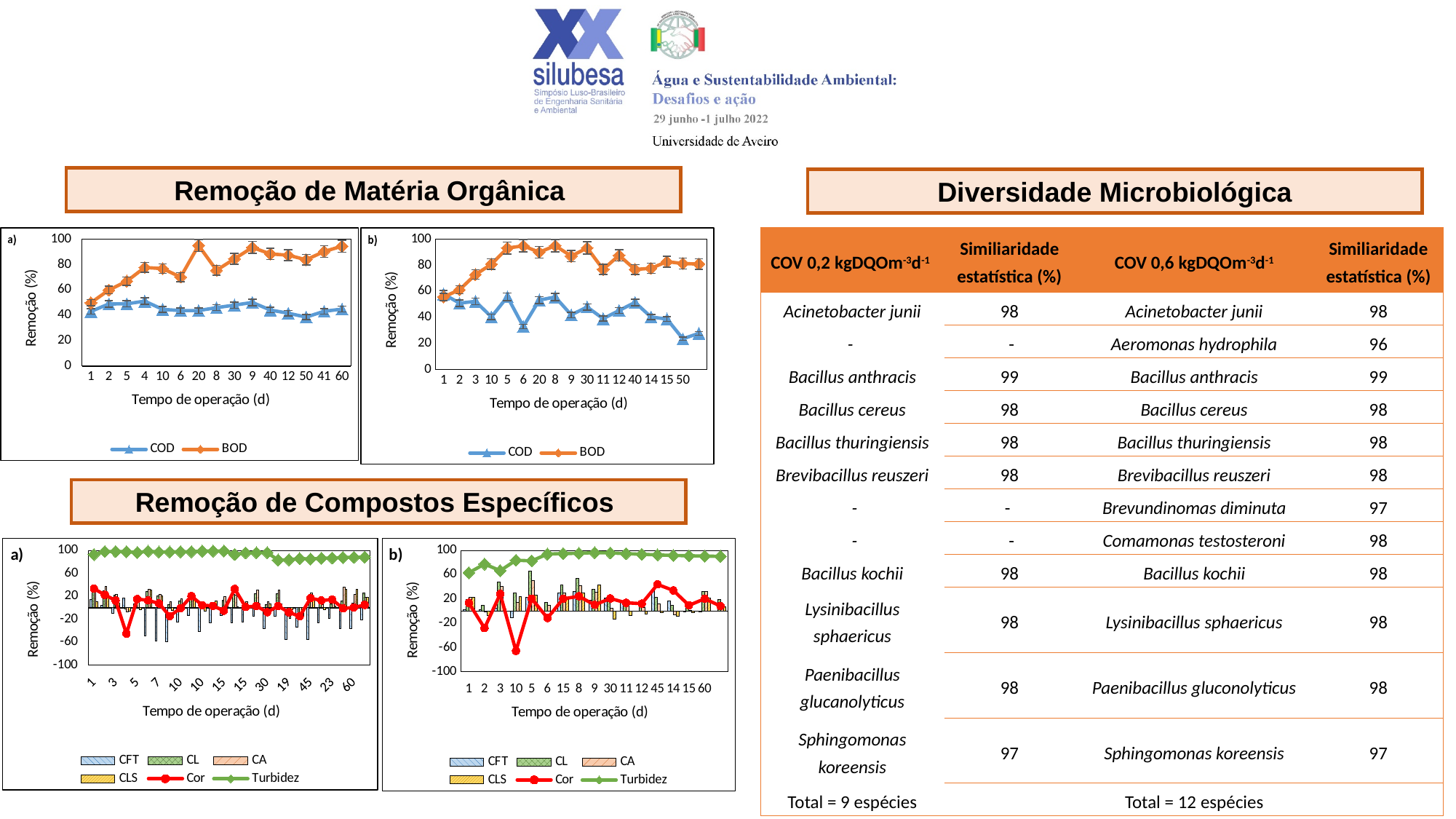
In chart b) under 'Remoção de Matéria Orgânica', does the COD series generally rise or fall along the x axis? fall In chart a) under 'Remoção de Matéria Orgânica', what kind of chart is it? line chart In chart a) under 'Remoção de Matéria Orgânica', how many series does the legend list? 2 In chart a) under 'Remoção de Compostos Específicos', how many series does the legend list? 6 In chart b) under 'Remoção de Matéria Orgânica', is the COD value at the last point greater or less than 40? less In chart a) under 'Remoção de Matéria Orgânica', does the BOD series generally rise or fall along the x axis? rise In chart a) under 'Remoção de Matéria Orgânica', is the BOD value at day 60 greater or less than 80? greater In chart b) under 'Remoção de Compostos Específicos', is the Cor value at day 10 greater or less than -20? less In chart a) under 'Remoção de Matéria Orgânica', which series is higher at day 60, COD or BOD? BOD What is the x-axis title of chart a) under 'Remoção de Matéria Orgânica'? Tempo de operação (d)